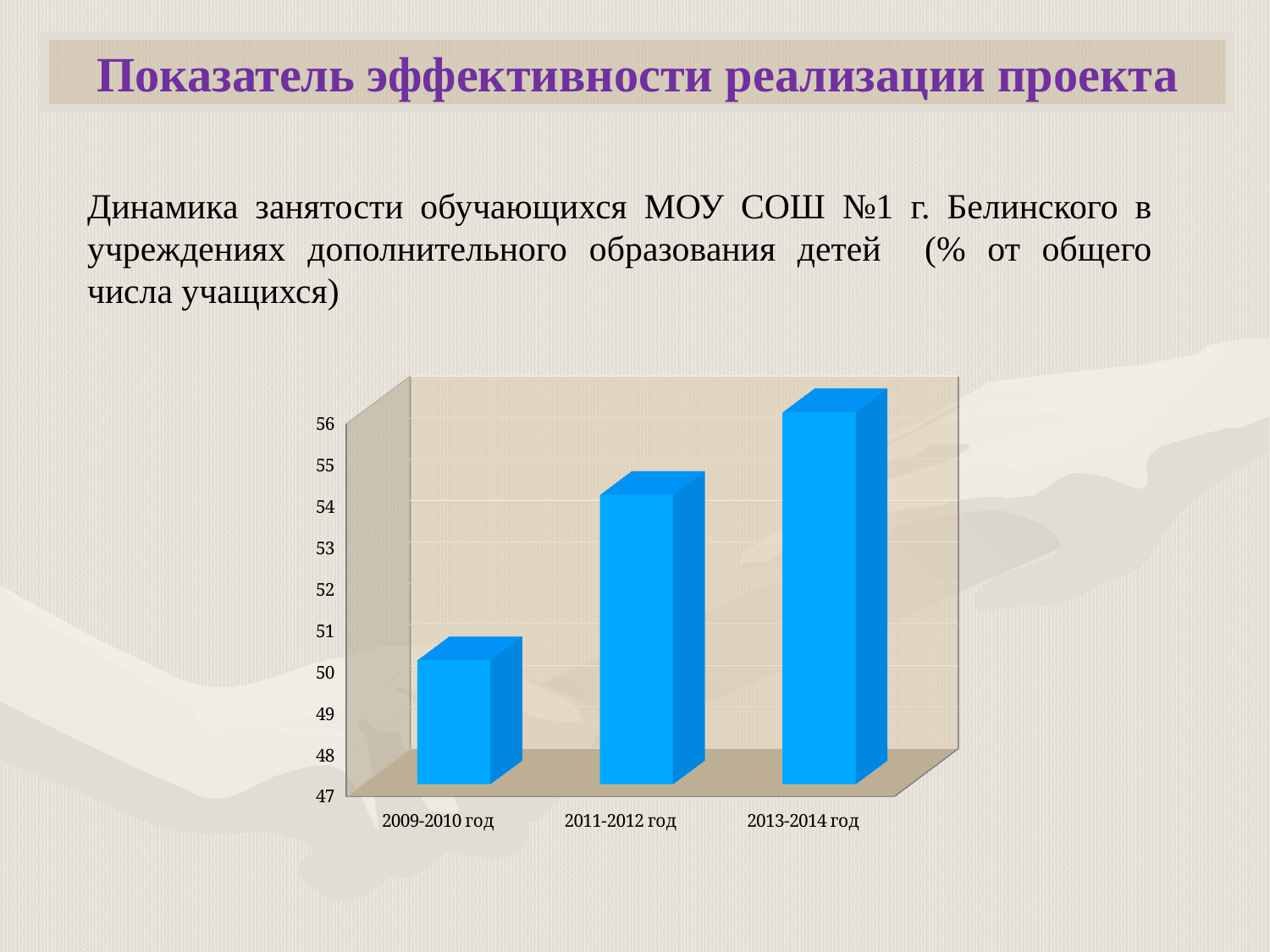
Is the value for 2013-2014 год greater or less than 54? greater Is the value for 2009-2010 год greater or less than 52? less Which is larger, the value for 2013-2014 год or the value for 2011-2012 год? 2013-2014 год Do the values rise or fall from 2009-2010 год to 2013-2014 год? rise Which school year has the highest bar on the chart? 2013-2014 год How many categories (school years) are plotted on the chart? 3 Which is larger, the value for 2011-2012 год or the value for 2009-2010 год? 2011-2012 год Is the value for 2011-2012 год greater or less than 52? greater What kind of chart is shown on the slide? bar chart Which school year has the lowest bar on the chart? 2009-2010 год What is the lowest value shown on the vertical axis of the chart? 47